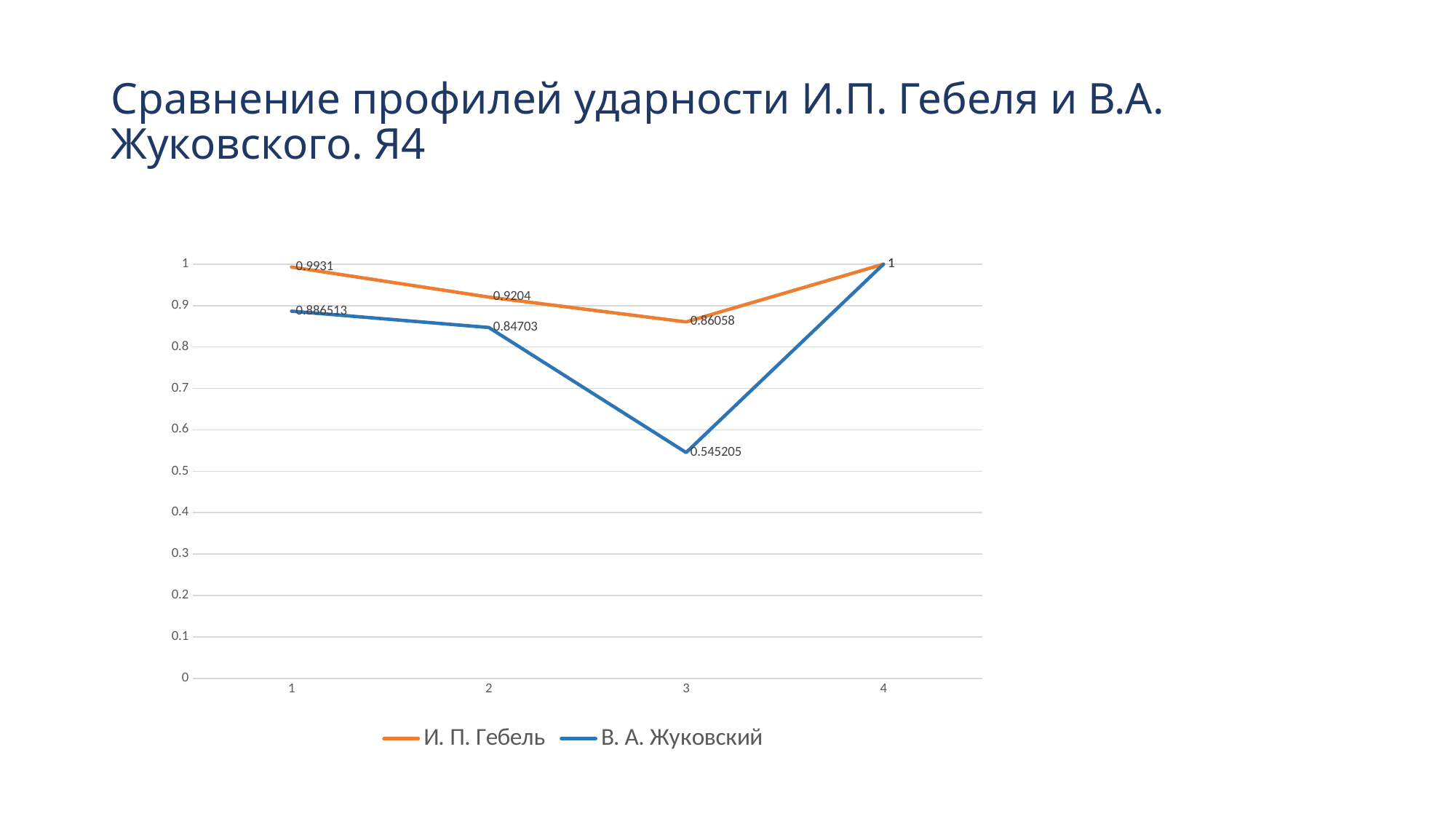
At which position is the value for И. П. Гебель lowest? 3 What kind of chart is shown on the slide? Line chart What is the value for И. П. Гебель at position 2? 0.9204 At which position is the value for В. А. Жуковский lowest? 3 What is the value for В. А. Жуковский at position 3? 0.545205 What is the value for И. П. Гебель at position 1? 0.9931 How many series does the legend list? 2 Is the value for В. А. Жуковский at position 3 greater or less than 0.6? less Which series has the larger value at position 3, И. П. Гебель or В. А. Жуковский? И. П. Гебель What is the difference between the values of И. П. Гебель and В. А. Жуковский at position 2? 0.07337 What is the value for В. А. Жуковский at position 1? 0.886513 How many positions are shown on the x axis? 4